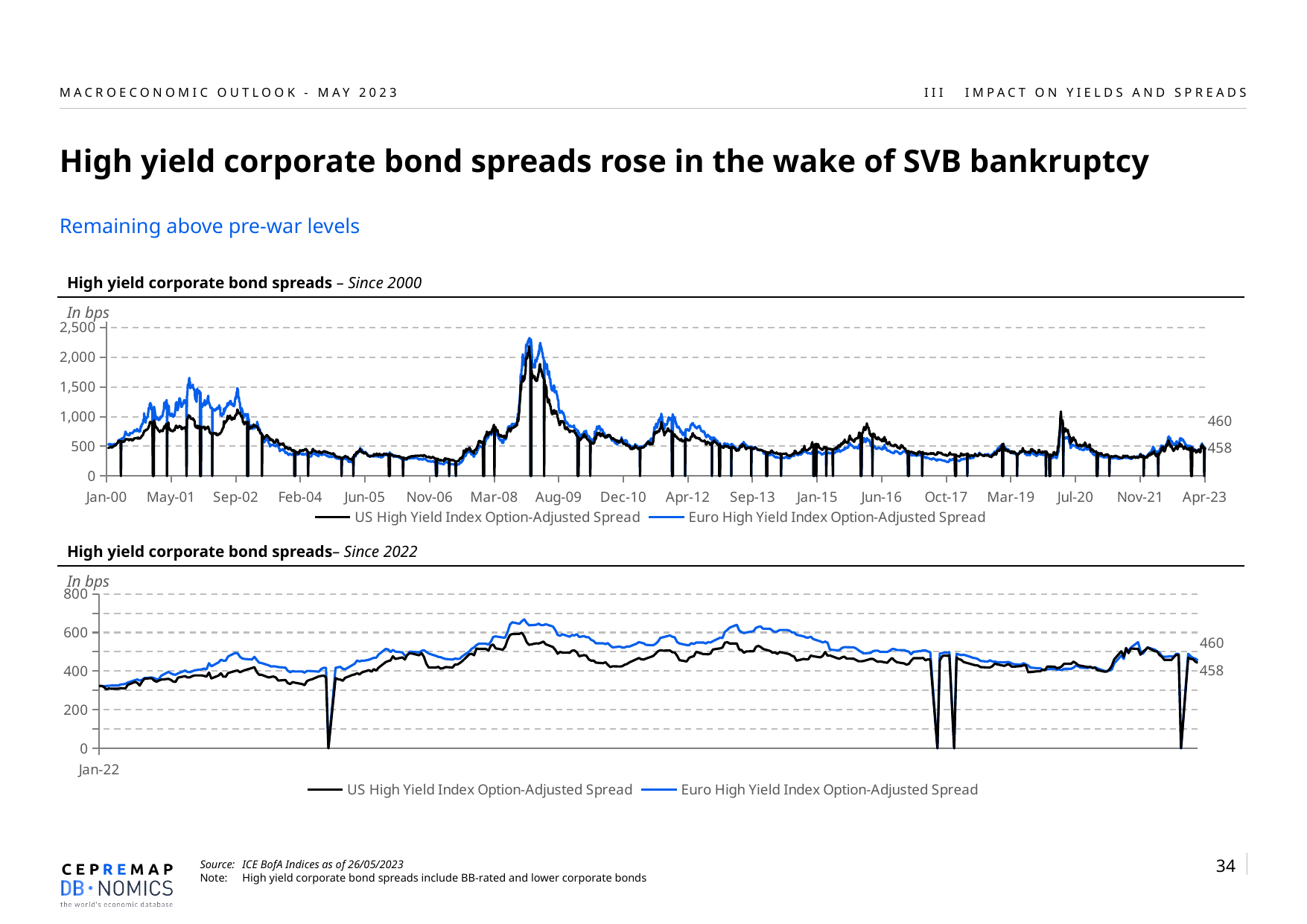
In the bottom chart, what is the first label on the x axis? Jan-22 In the bottom chart, 'High yield corporate bond spreads – Since 2022', what is the highest value shown on the y axis? 800 What kind of chart is the top chart, 'High yield corporate bond spreads – Since 2000'? Line chart In the top chart, what are the two series named in the legend? US High Yield Index Option-Adjusted Spread and Euro High Yield Index Option-Adjusted Spread In the top chart, is the peak value of the Euro High Yield Index Option-Adjusted Spread around 2008-2009 greater or less than 2,000? greater In the top chart, what two values are labelled at the right end of the lines? 460 and 458 In the bottom chart, is the peak value of the Euro High Yield Index Option-Adjusted Spread in 2022 greater or less than 600? greater How many series does the legend of the top chart list? 2 In the bottom chart, is the value of the US High Yield Index Option-Adjusted Spread at Jan-22 greater or less than 400? less In the top chart, what is the highest value shown on the y axis? 2,500 In the bottom chart, which series is generally higher during 2022, the US or the Euro High Yield Index Option-Adjusted Spread? Euro High Yield Index Option-Adjusted Spread In the bottom chart, do the spreads rise or fall from Jan-22 to mid-2022? rise